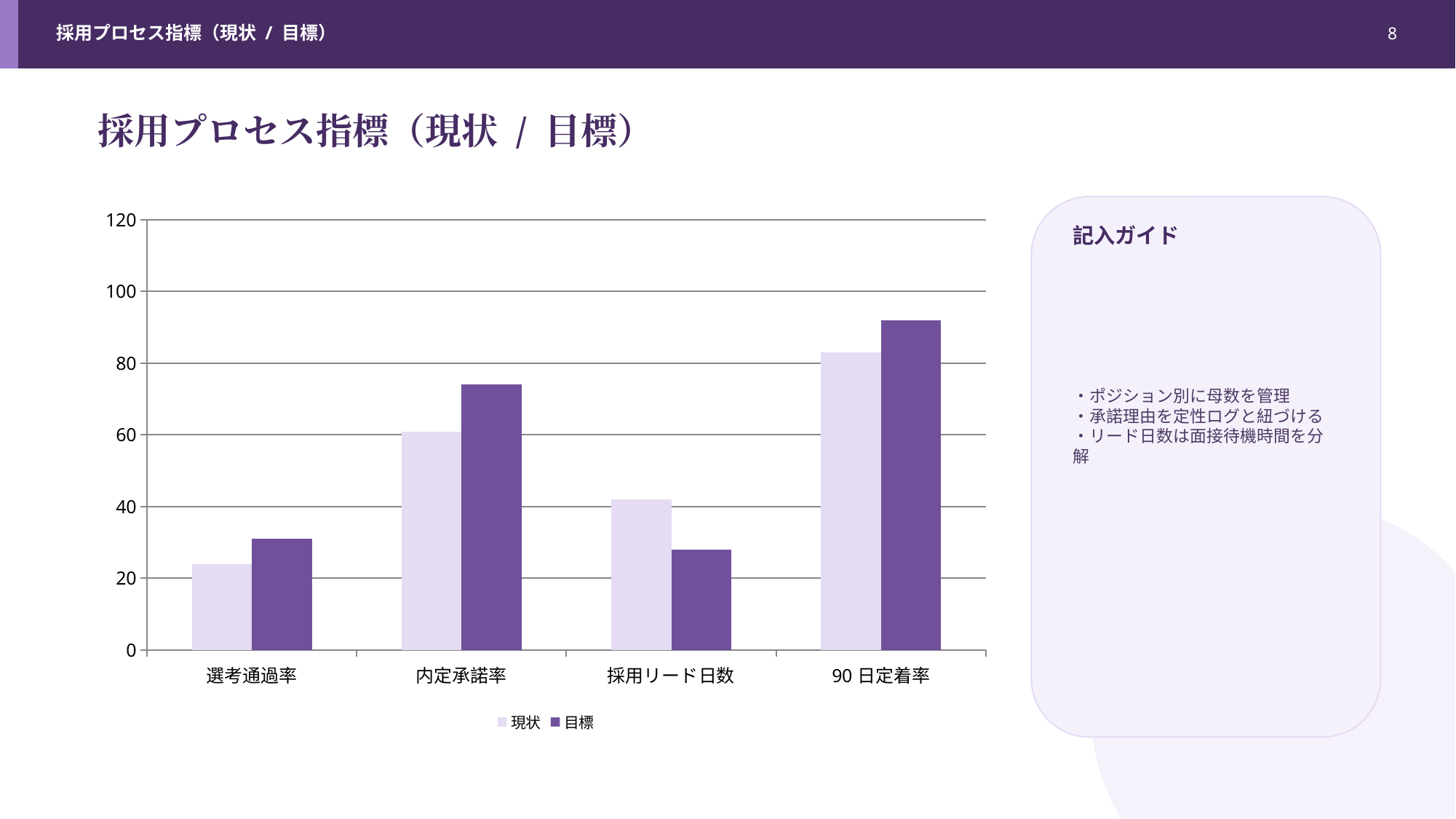
How many categories are shown on the x axis? 4 Which category has the lowest 現状 value? 選考通過率 Which category has the highest 現状 value? 90 日定着率 Is the 現状 value for 選考通過率 greater or less than 40? less Which is larger, the 目標 value for 内定承諾率 or the 目標 value for 90 日定着率? 90 日定着率 What are the two series named in the legend? 現状 and 目標 Is the 目標 value for 内定承諾率 greater or less than 60? greater What kind of chart is shown on the slide? bar chart For 採用リード日数, which is larger, the 現状 value or the 目標 value? 現状 How many series does the legend list? 2 Which category has the highest 目標 value? 90 日定着率 Is the 目標 value for 採用リード日数 greater or less than 40? less